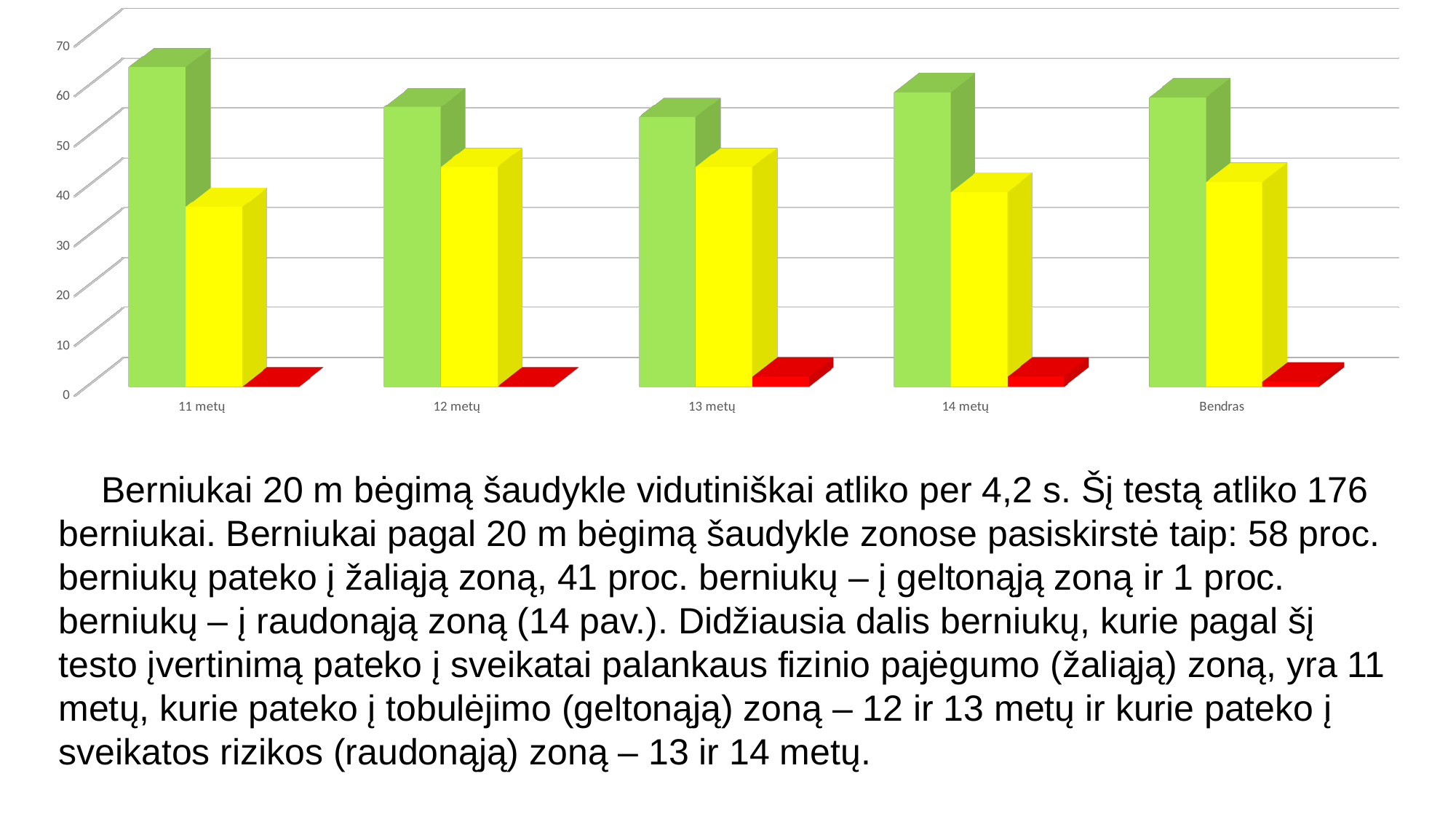
Is the red bar for Bendras greater or less than 10? less Which is larger, the yellow bar for 12 metų or the yellow bar for 14 metų? 12 metų Which is larger, the green bar for 11 metų or the green bar for 12 metų? 11 metų What colours are the three bars in each category group? green, yellow and red Is the yellow bar for 12 metų greater or less than 40? greater What kind of chart is shown on the slide? bar chart Is the yellow bar for 11 metų greater or less than 40? less Which category has the tallest green bar? 11 metų How many categories are shown on the x axis of the chart? 5 How many bars are plotted for each category on the chart? 3